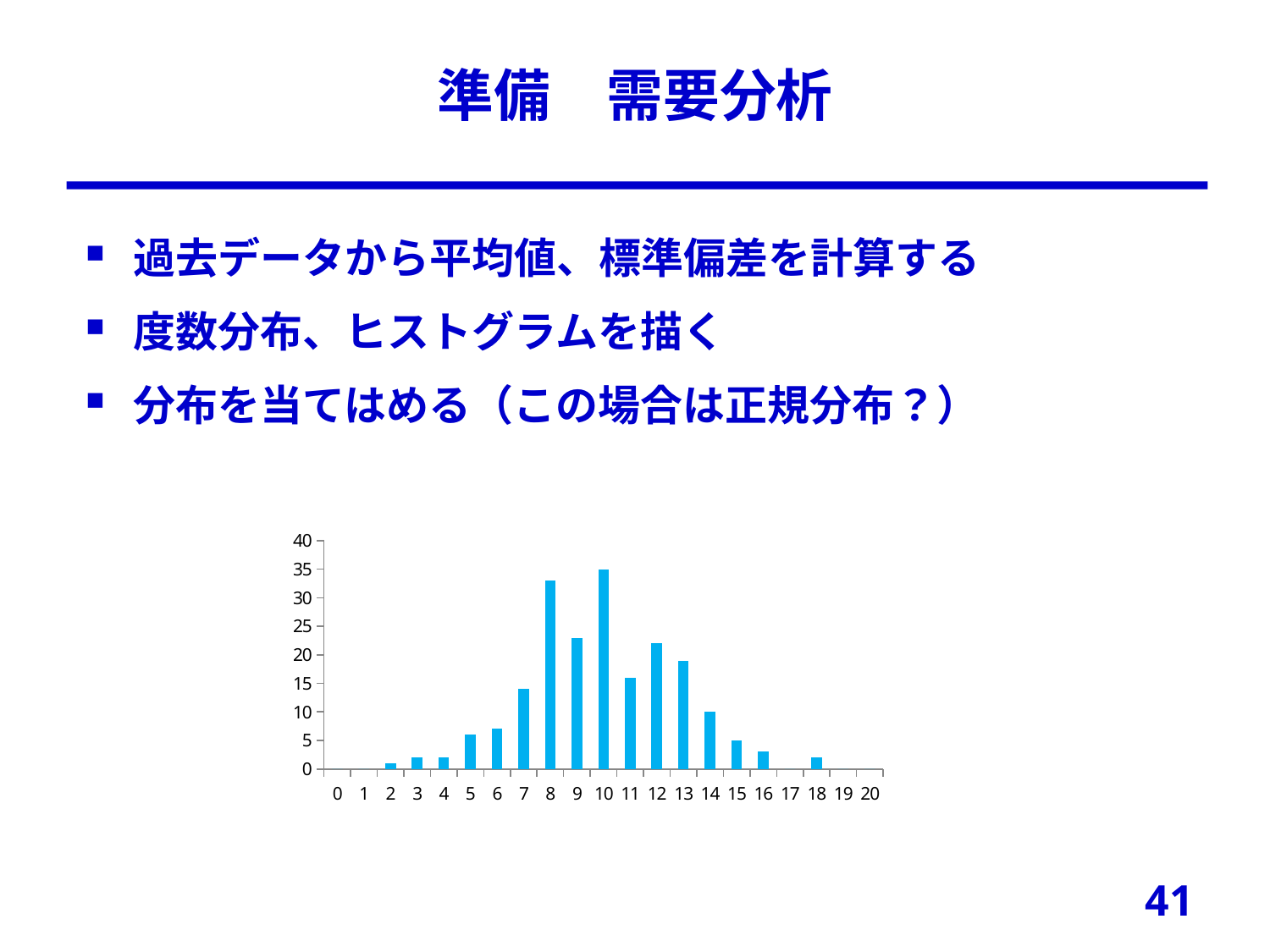
What is the highest value shown on the y axis? 40 Which x-axis category has the tallest bar? 10 Is the value for category 8 greater or less than 30? greater Which has the larger value, category 12 or category 13? 12 Is the value for category 16 greater or less than 5? less How many categories are labelled on the x axis? 21 Is the value for category 9 greater or less than 20? greater What kind of chart is shown on the slide? bar chart Do the values rise or fall along the x axis from category 12 to category 16? fall Which has the larger value, category 8 or category 9? 8